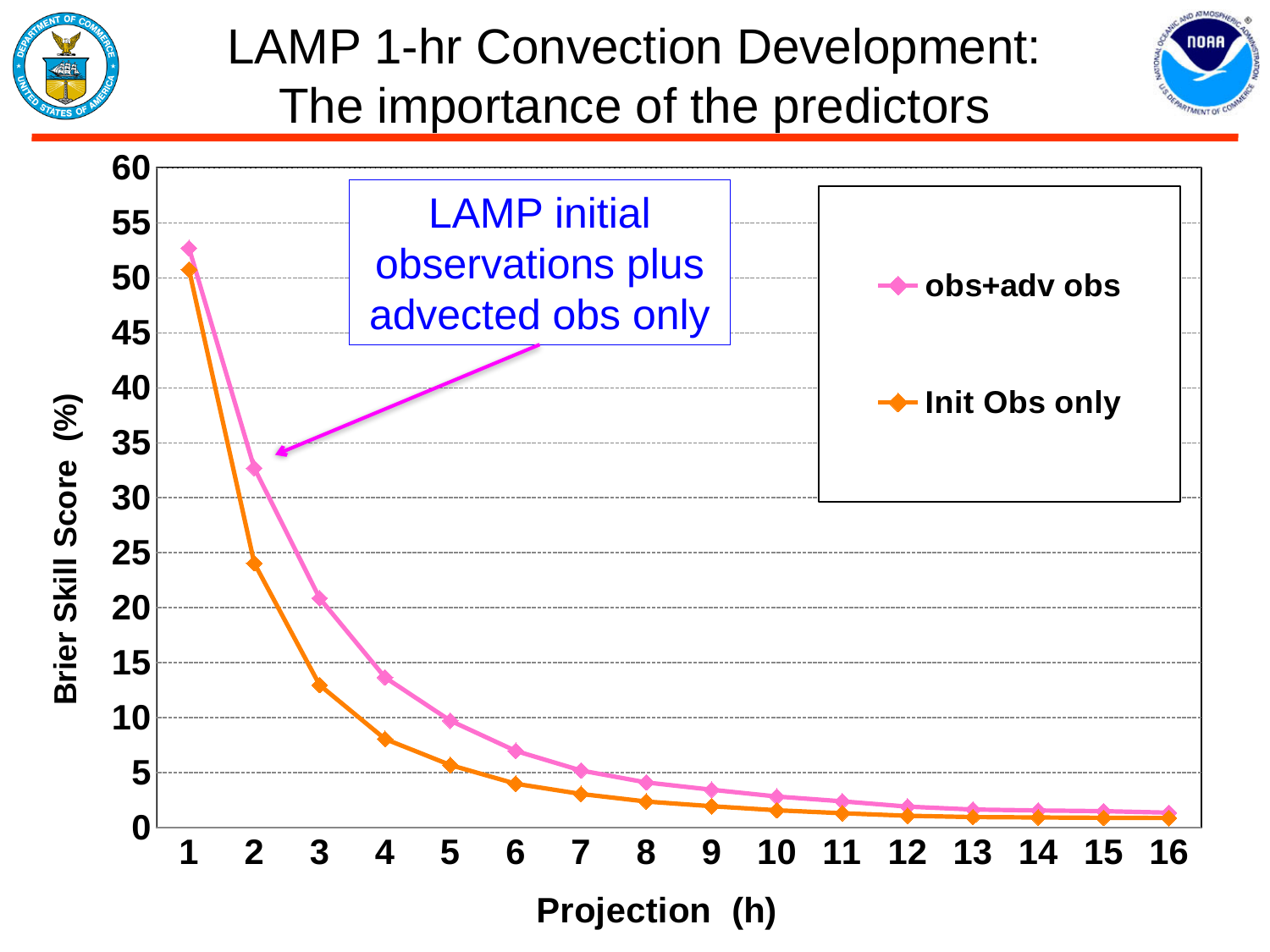
Do the Brier Skill Score values rise or fall as the projection hour increases? fall What kind of chart is shown on the slide? line chart Is the value for Init Obs only at projection 3 greater or less than 15? less Is the value for Init Obs only at projection 2 greater or less than 20? greater How many projection hours are plotted along the x axis? 16 How many series does the legend list? 2 Is the value for obs+adv obs at projection 2 greater or less than 30? greater What is the label of the x axis? Projection (h) What is the label of the y axis? Brier Skill Score (%) At projection 3, which series has the higher Brier Skill Score, obs+adv obs or Init Obs only? obs+adv obs